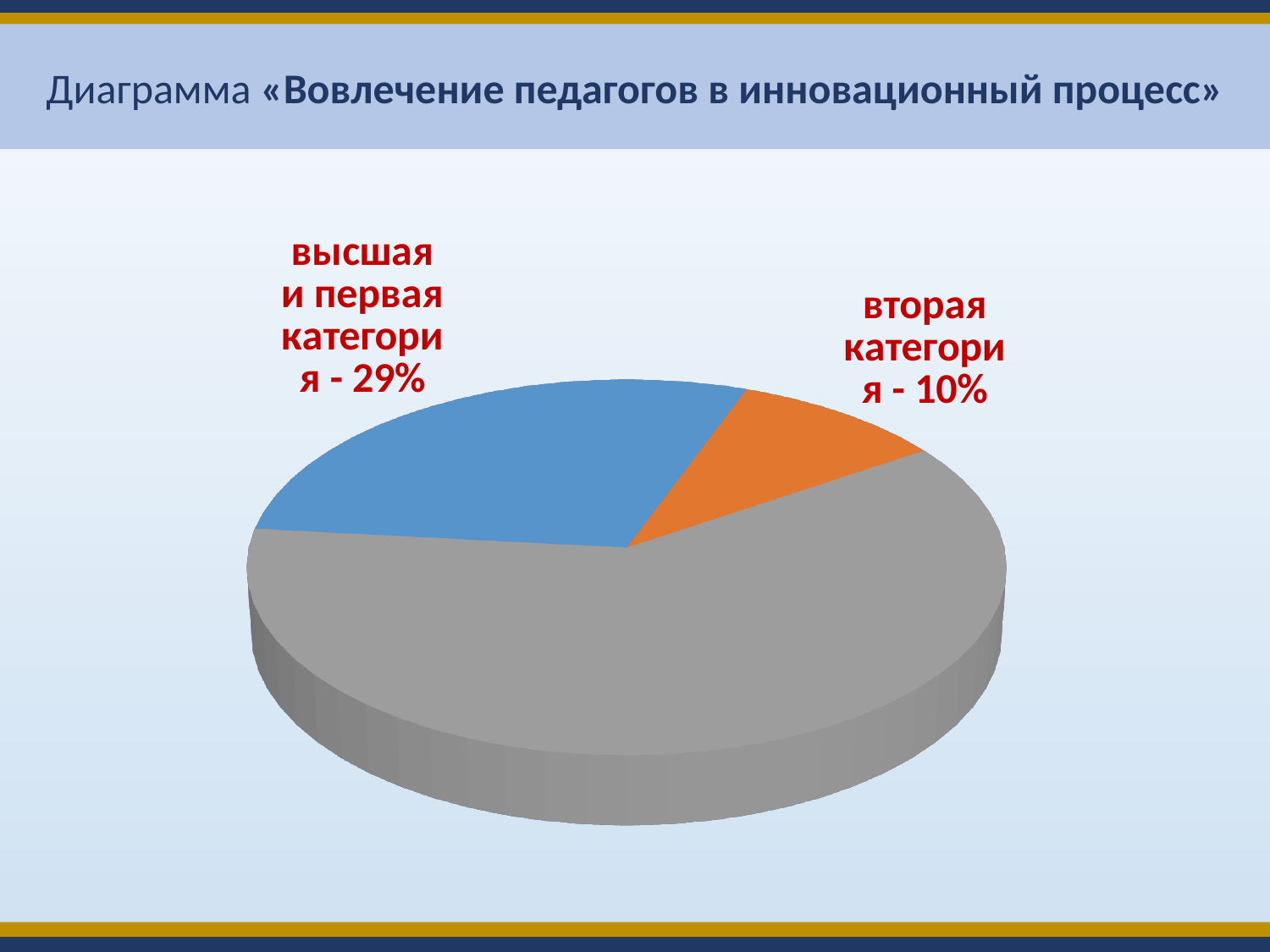
What percentage is shown for «вторая категория»? 10% What is the difference between the values for «высшая и первая категория» and «вторая категория»? 19% What kind of chart is shown on the slide? pie chart What is the title of the chart on the slide? «Вовлечение педагогов в инновационный процесс» What percentage is shown for «высшая и первая категория»? 29% Which of the two labelled slices is larger: «высшая и первая категория» or «вторая категория»? высшая и первая категория How many slices does the pie chart have? 3 What colour is the slice for «высшая и первая категория»? blue